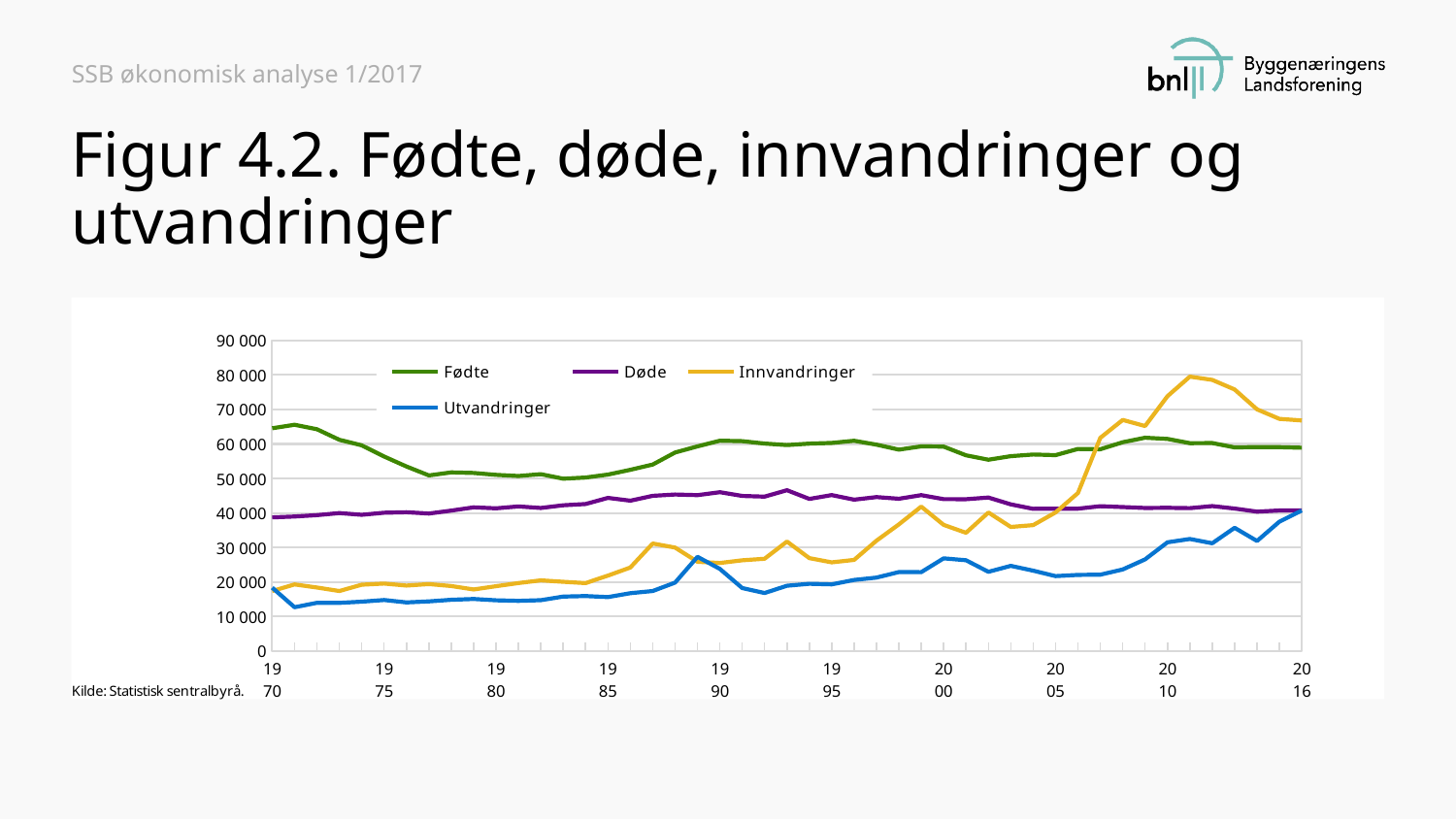
Does the Innvandringer line rise or fall between 2005 and 2011? rise Is the value for Utvandringer in 1975 greater or less than 20 000? less Which series has the lowest value in 1980? Utvandringer Which series are listed in the legend? Fødte, Døde, Innvandringer, Utvandringer Is the value for Fødte in 1970 greater or less than 60 000? greater Is the value for Innvandringer around 2011 greater or less than 70 000? greater Which series has the highest value in 1970? Fødte What kind of chart is shown on the slide? line chart Which series reaches the highest value anywhere on the chart? Innvandringer In 1990, which is larger: Fødte or Døde? Fødte How many series does the legend list? 4